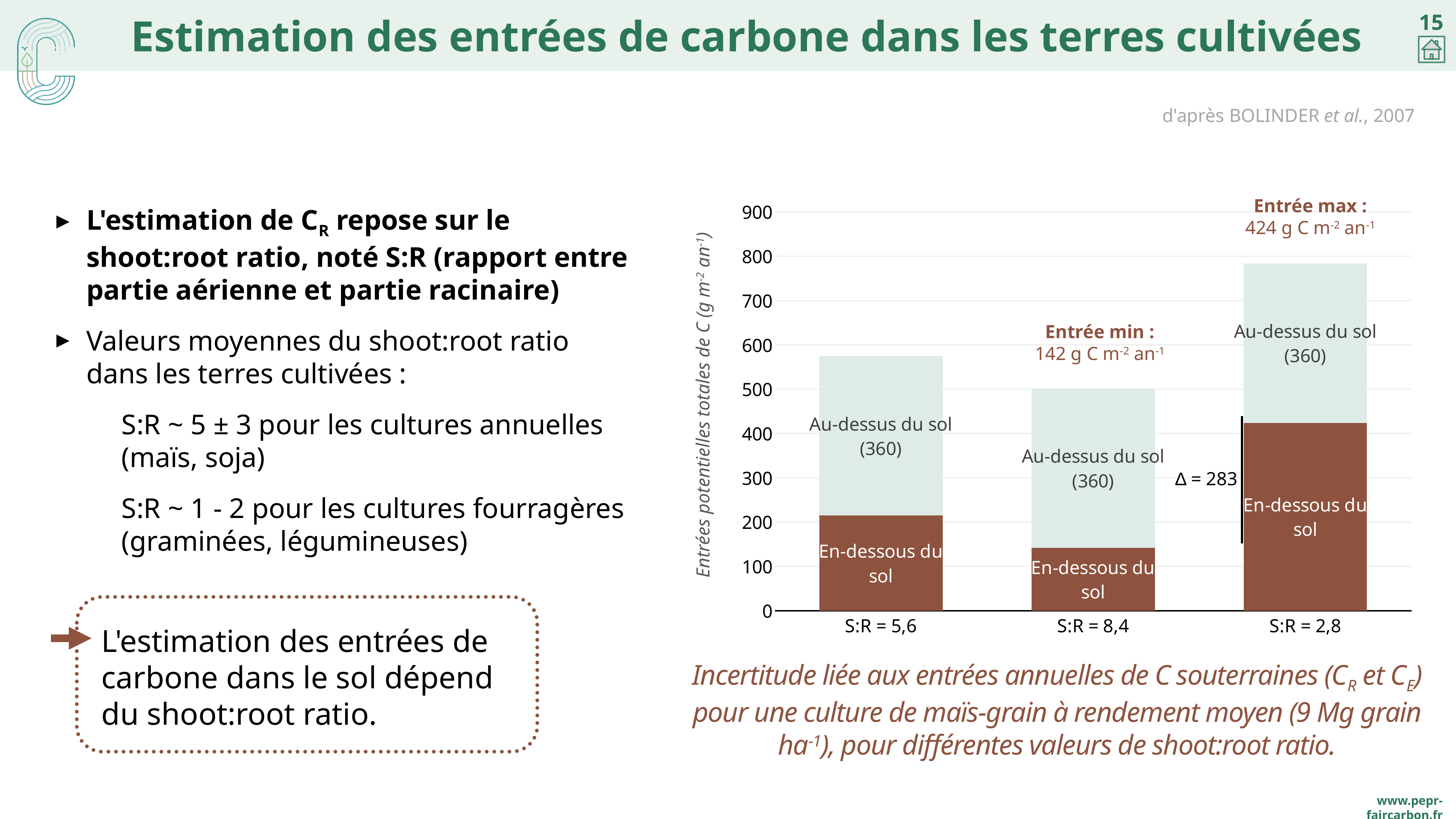
What is the Δ value annotated between the minimum and maximum below-ground entries? Δ = 283 How many S:R categories are plotted on the x axis? 3 Which stacked bar is taller overall, S:R = 2,8 or S:R = 5,6? S:R = 2,8 What kind of chart is shown on the slide? stacked bar chart What is the total height of the stacked bar for S:R = 8,4 (above-ground plus below-ground)? 502 Which S:R category has the highest below-ground carbon entry? S:R = 2,8 Which S:R category has the lowest below-ground carbon entry? S:R = 8,4 What is the below-ground ("En-dessous du sol") value for S:R = 8,4, labelled as the minimum entry? 142 g C m-2 an-1 What is the total height of the stacked bar for S:R = 2,8 (above-ground plus below-ground)? 784 Is the total stacked value for S:R = 5,6 greater or less than 500? greater What is the maximum entry ("Entrée max") value shown for S:R = 2,8? 424 g C m-2 an-1 What is the above-ground ("Au-dessus du sol") value for S:R = 5,6? 360